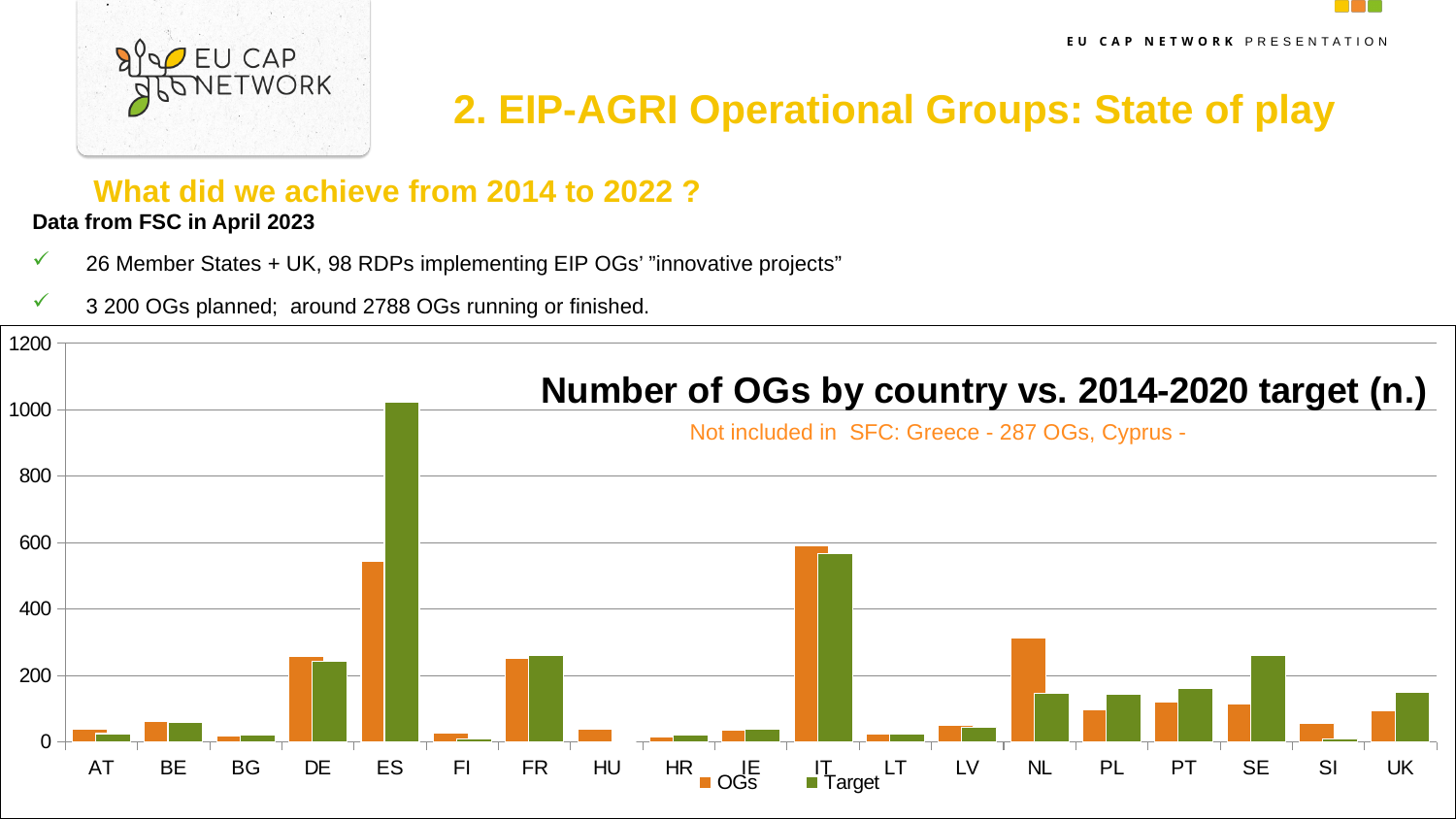
How many series does the legend list? 2 Is the OGs value for ES greater or less than 400? greater Which country has the highest Target value? ES How many countries are shown on the x axis of the chart? 19 For NL, which is larger, the OGs value or the Target value? OGs For ES, which is larger, the OGs value or the Target value? Target What is the title of the chart? Number of OGs by country vs. 2014-2020 target (n.) Is the Target value for UK greater or less than 200? less Is the Target value for ES greater or less than 1000? greater Which country has the highest OGs value? IT What kind of chart is shown on the slide? bar chart